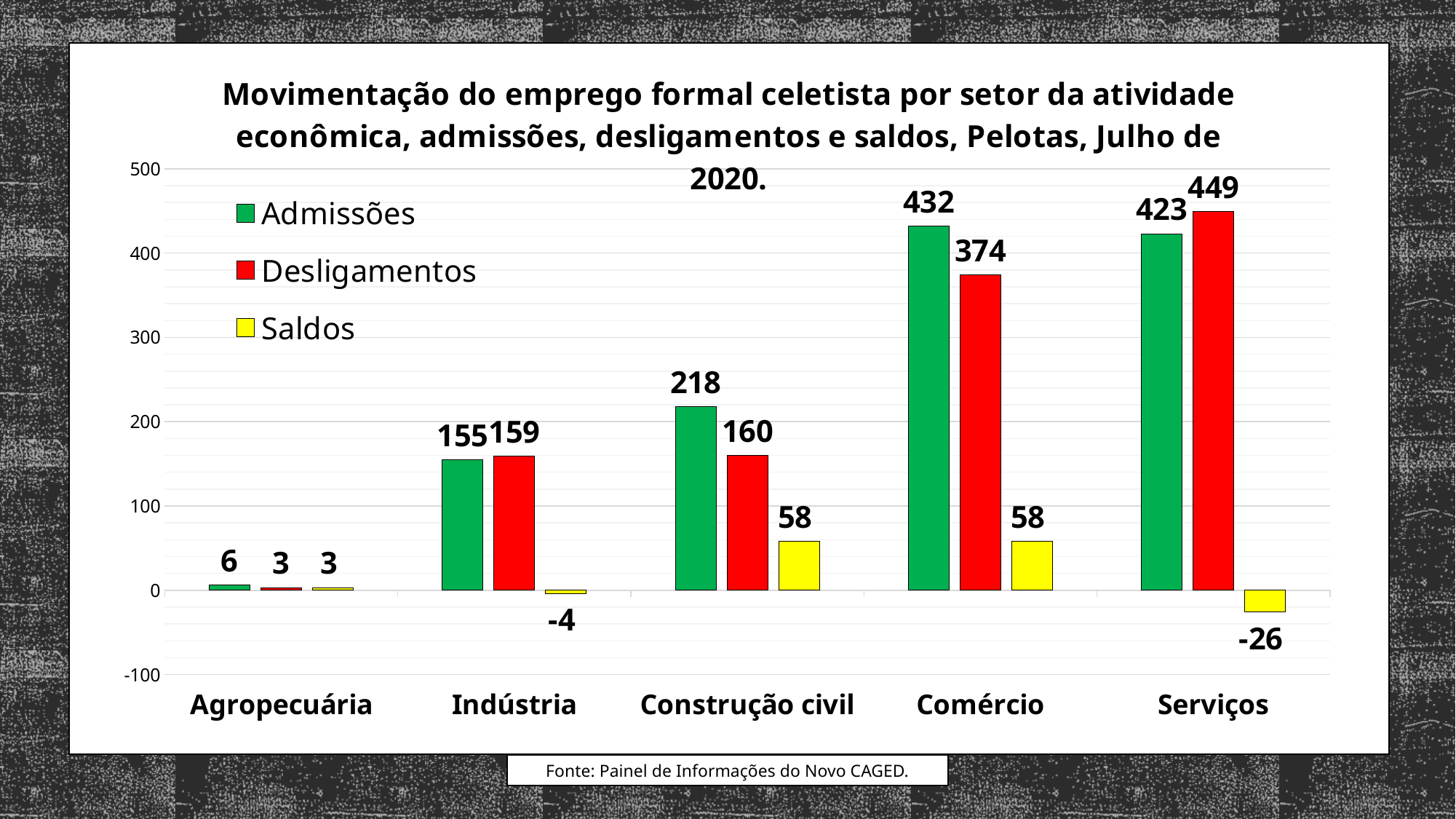
What is the Admissões value for Comércio? 432 What kind of chart is shown on the slide? bar chart Which sector has the highest Desligamentos value? Serviços What is the Saldos value for Indústria? -4 How many series does the legend list? 3 What is the difference between Admissões and Desligamentos for Construção civil? 58 What colour represents the Saldos series? yellow Is the Admissões value for Comércio greater or less than 400? greater Which sector has the lowest Admissões value? Agropecuária How many sectors are shown on the x axis? 5 What is the Desligamentos value for Serviços? 449 Which is larger for Serviços, Admissões or Desligamentos? Desligamentos